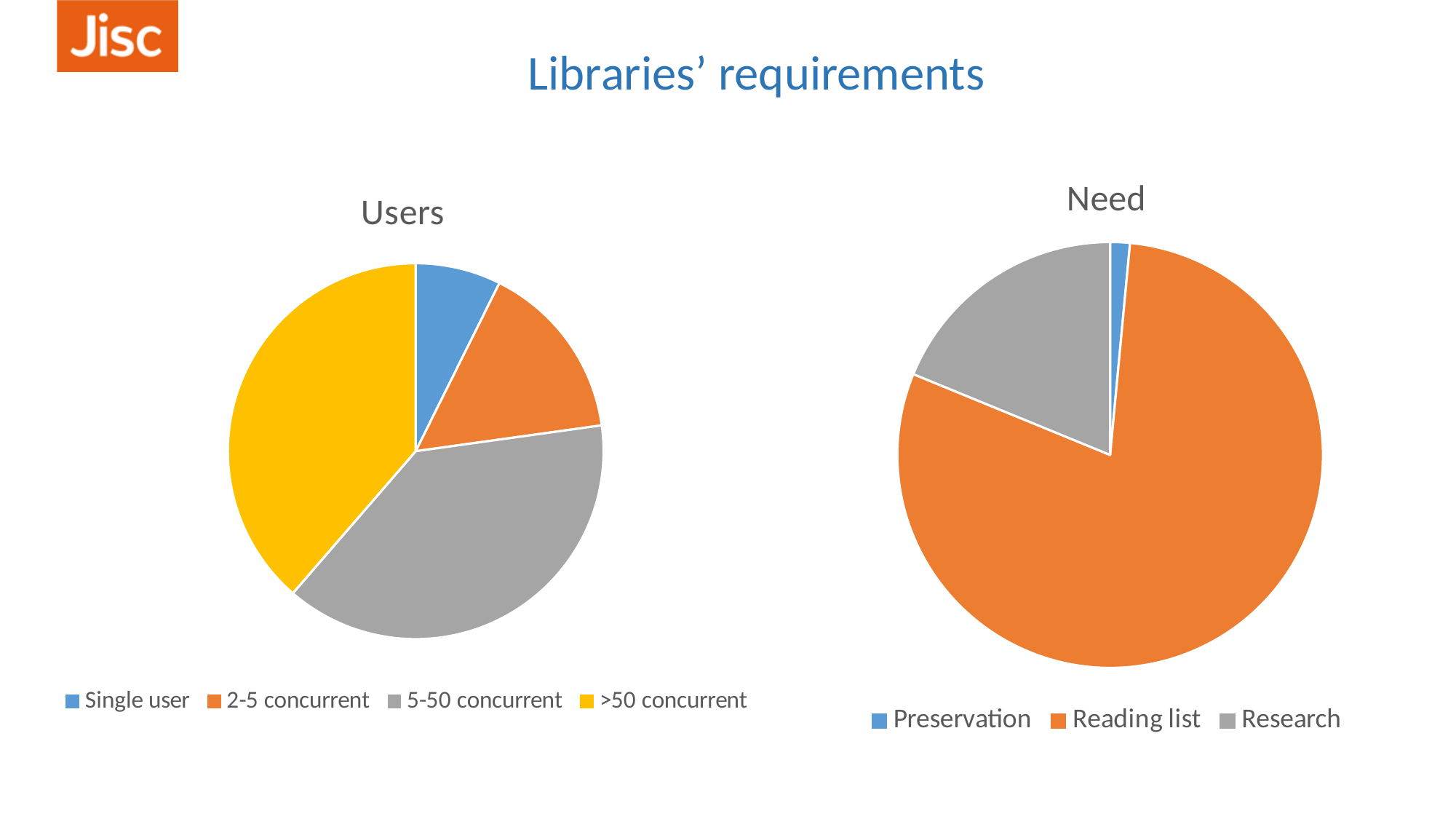
What kind of chart is the "Users" chart? pie chart In the "Need" chart, which category has the smallest slice? Preservation In the "Users" chart, which category has the smallest slice? Single user How many entries does the legend of the "Need" chart list? 3 In the "Need" chart, which category has the largest slice? Reading list How many slices does the "Need" pie chart have? 3 In the "Users" chart, which slice is larger: 5-50 concurrent or 2-5 concurrent? 5-50 concurrent How many entries does the legend of the "Users" chart list? 4 How many slices does the "Users" pie chart have? 4 What kind of chart is the "Need" chart? pie chart In the "Need" chart, which slice is larger: Research or Preservation? Research In the "Users" chart, which colour represents the >50 concurrent category? yellow